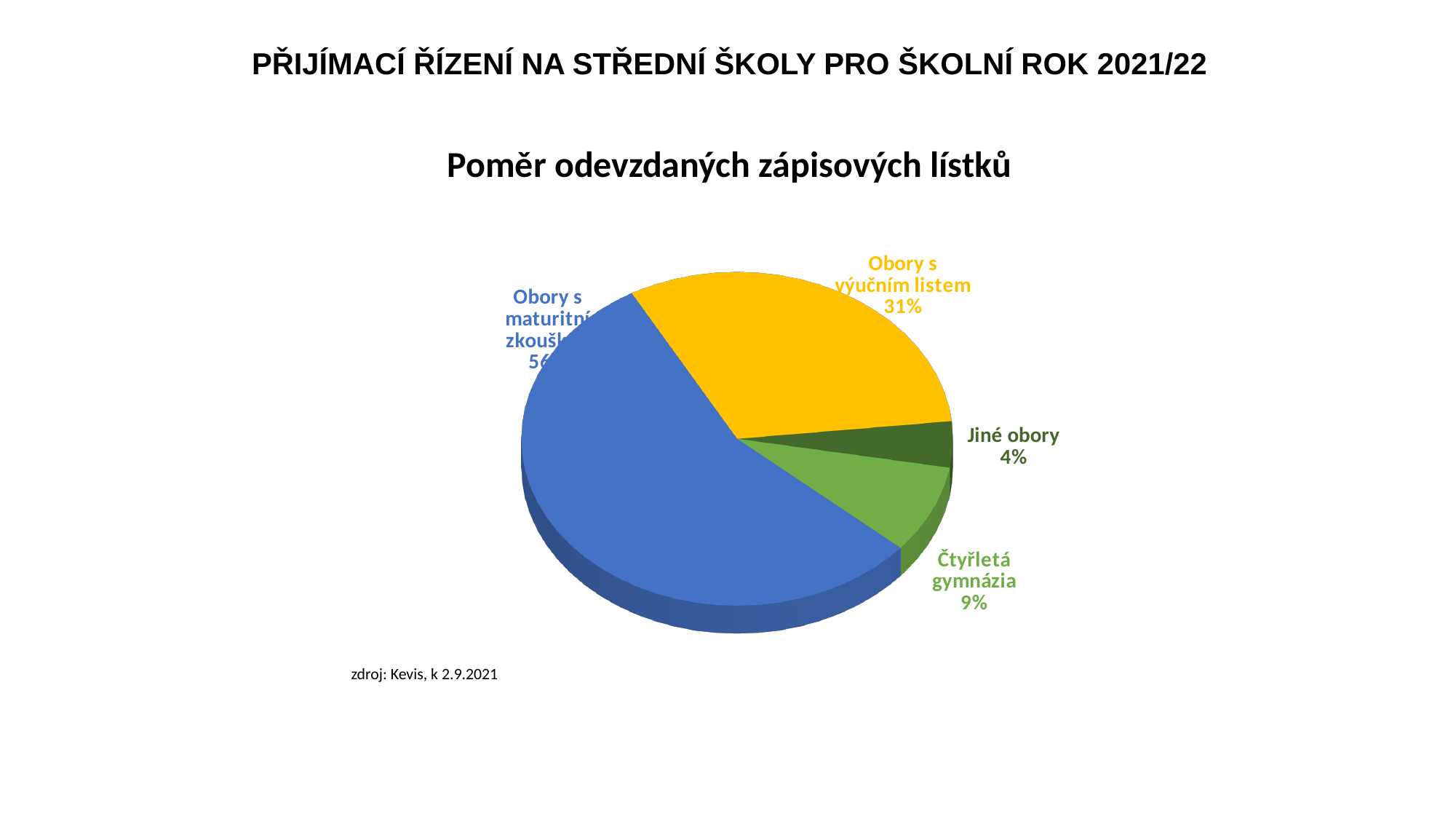
Which is larger: the share for Obory s výučním listem or for Čtyřletá gymnázia? Obory s výučním listem Which is larger: the share for Čtyřletá gymnázia or for Jiné obory? Čtyřletá gymnázia How many slices does the pie chart have? 4 What type of chart is shown on the slide? Pie chart Which category has the largest slice of the pie? Obory s maturitní zkouškou What is the title of the chart? Poměr odevzdaných zápisových lístků How many percentage points larger is the share of Obory s výučním listem than that of Čtyřletá gymnázia? 22 percentage points What is the difference in percentage points between Čtyřletá gymnázia and Jiné obory? 5 percentage points What share of the pie does Obory s výučním listem hold? 31% What percentage is shown for Jiné obory? 4% What percentage is shown for Čtyřletá gymnázia? 9% Which category has the smallest slice of the pie? Jiné obory